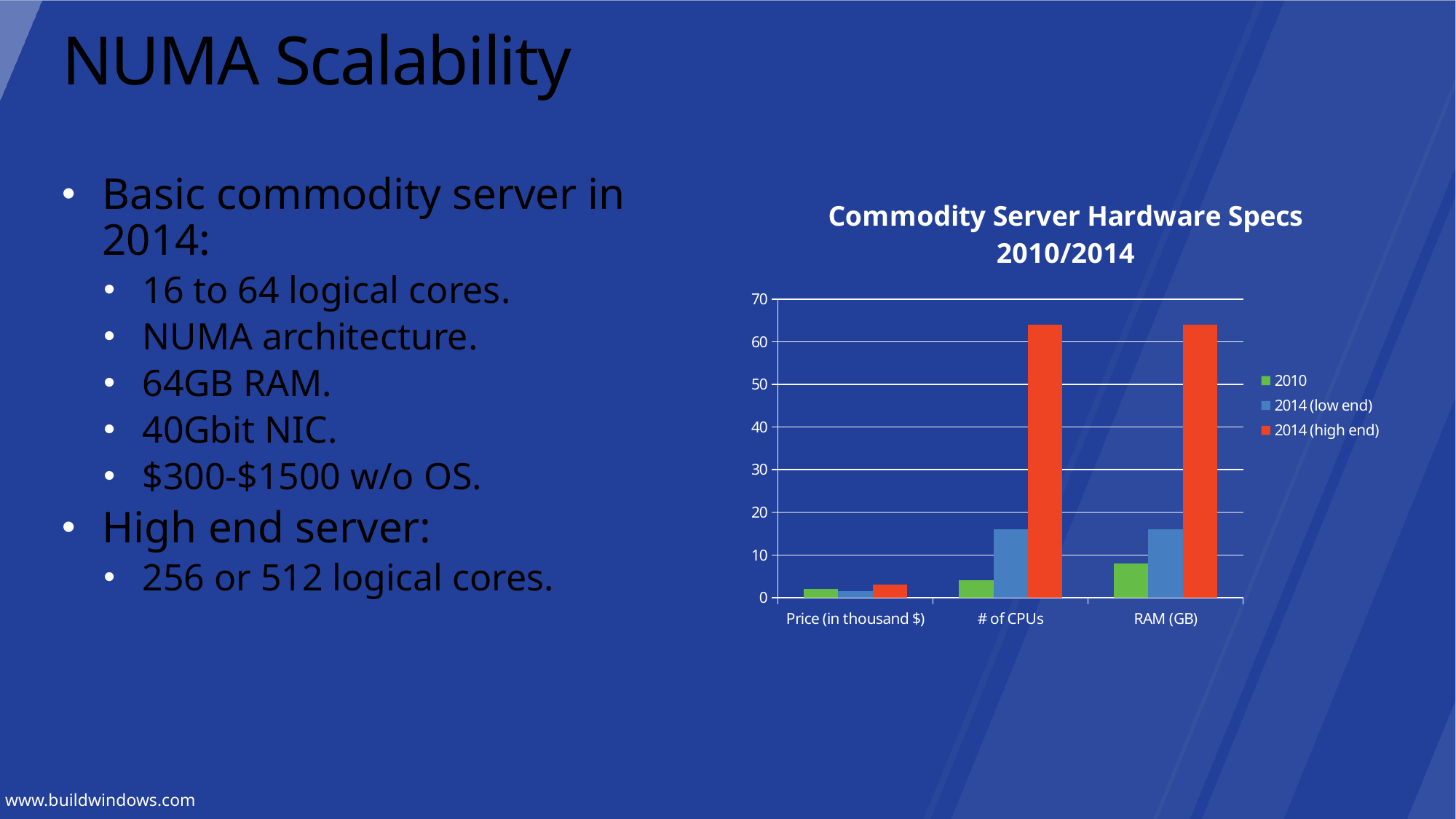
Which category has the tallest 2010 bar? RAM (GB) Which series has the highest bar for # of CPUs? 2014 (high end) Is the 2010 value for # of CPUs greater or less than 10? less How many categories are shown on the x axis of the chart? 3 What is the title of the chart? Commodity Server Hardware Specs 2010/2014 Is the 2014 (low end) value for RAM (GB) greater or less than 10? greater Which category has the lowest 2014 (high end) bar? Price (in thousand $) Is the 2014 (high end) value for # of CPUs greater or less than 60? greater What kind of chart is shown on the slide? bar chart How many series does the chart's legend list? 3 Which colour represents the 2014 (high end) series in the legend? red For # of CPUs, which is larger: the 2014 (low end) bar or the 2014 (high end) bar? 2014 (high end)